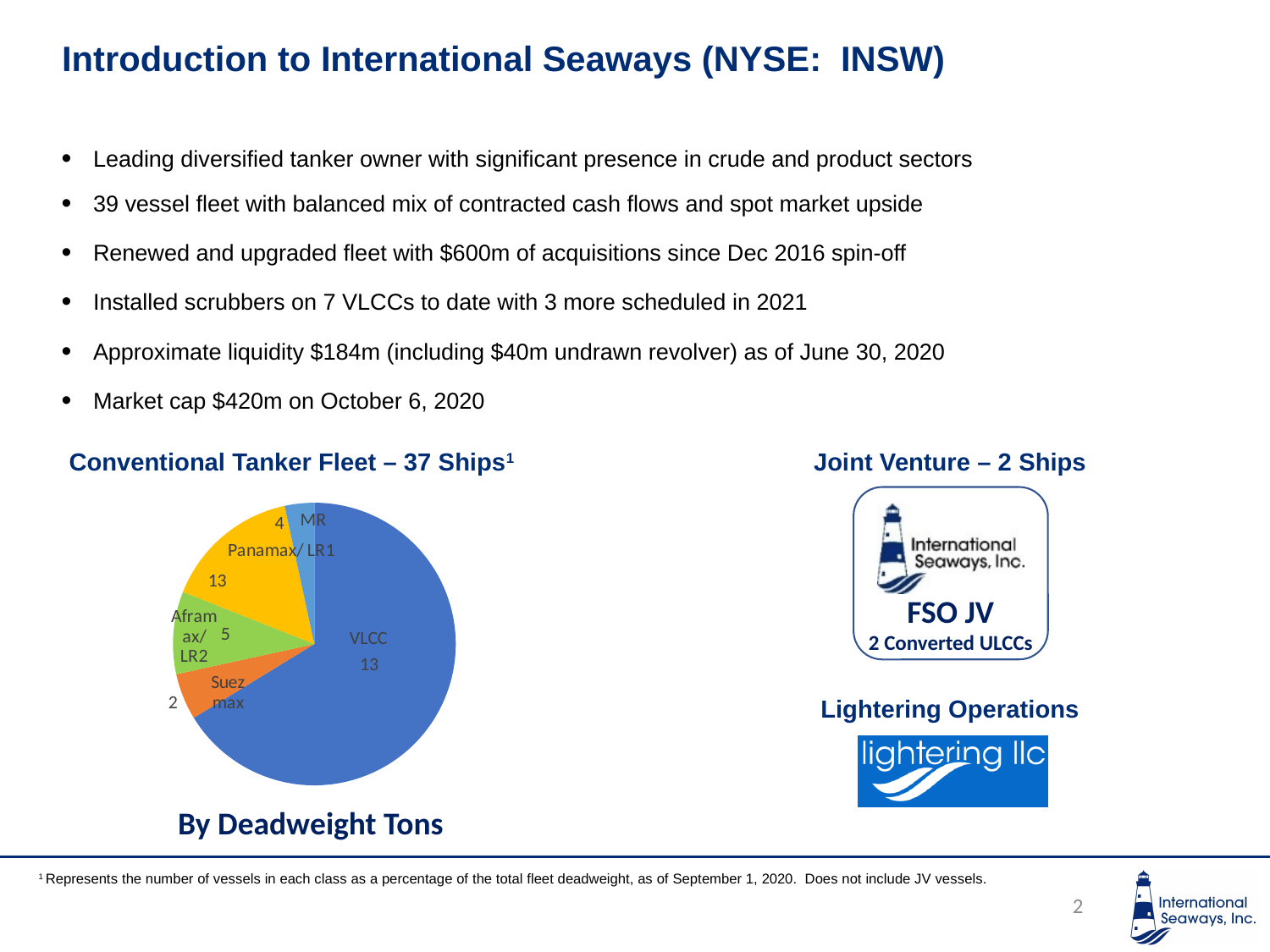
What type of chart is shown under the heading "Conventional Tanker Fleet – 37 Ships"? pie chart What caption appears directly below the pie chart? By Deadweight Tons What is the difference between the printed numbers for Panamax/LR1 and MR in the pie chart? 9 Which has the larger printed number in the pie chart, Aframax/LR2 or MR? Aframax/LR2 What number is printed for the MR slice of the pie chart? 4 Which slice takes up the largest area of the pie chart? VLCC What number is printed for the Suezmax slice of the pie chart? 2 Which vessel class has the smallest printed number in the pie chart? Suezmax What number is printed for the Panamax/LR1 slice of the pie chart? 13 How many vessel classes (slices) does the pie chart show? 5 What number is printed for the VLCC slice of the pie chart? 13 What number is printed for the Aframax/LR2 slice of the pie chart? 5